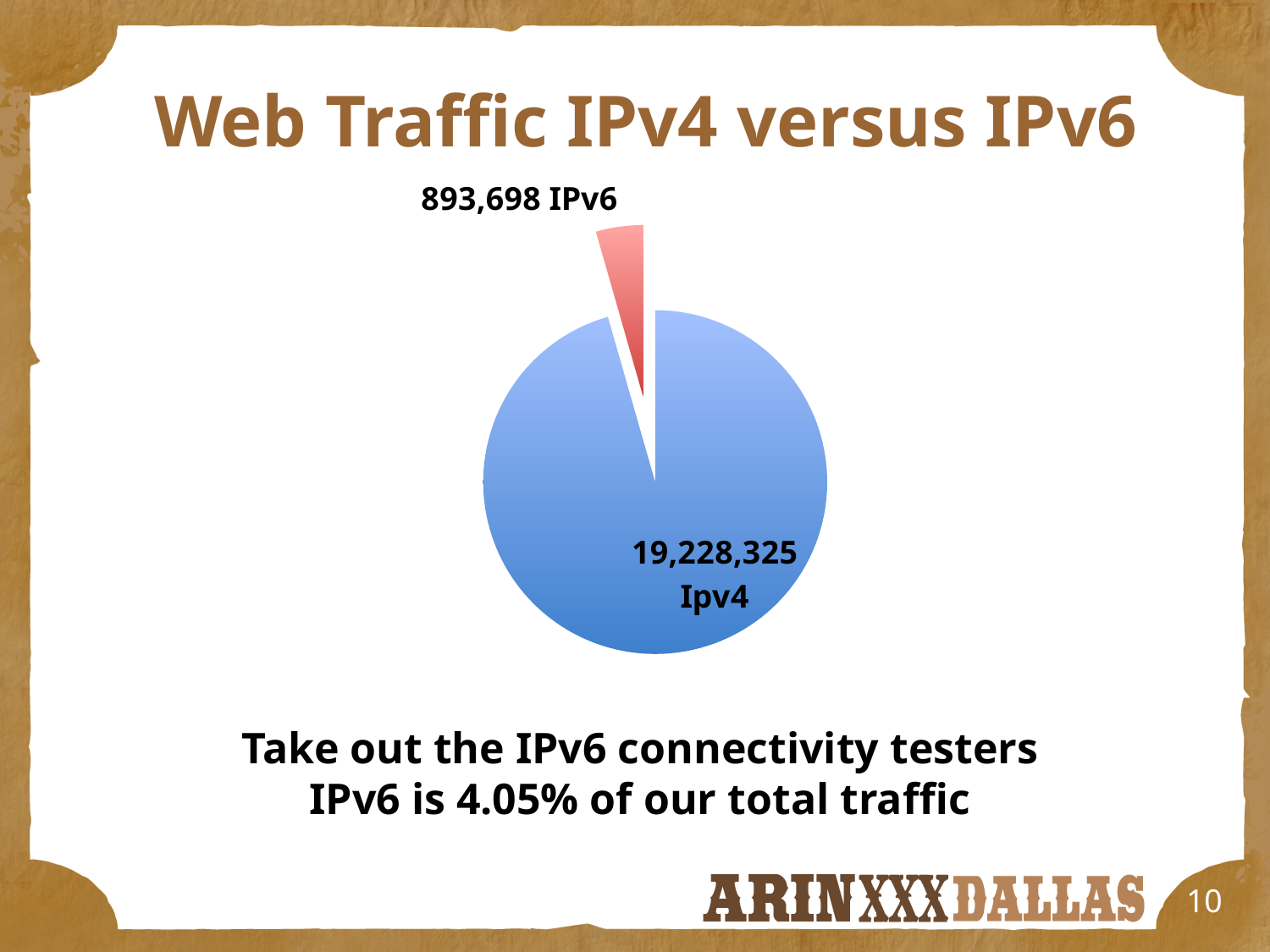
What is the difference between the IPv4 value and the IPv6 value? 18,334,627 What type of chart is shown on the slide? pie chart What is the value shown for IPv6 in the pie chart? 893,698 Which is larger, the IPv4 value or the IPv6 value? IPv4 How many slices does the pie chart have? 2 Which slice of the pie chart is the smallest? IPv6 What is the value shown for Ipv4 in the pie chart? 19,228,325 What is the title of the chart on the slide? Web Traffic IPv4 versus IPv6 What colour is the IPv6 slice in the pie chart? red What is the total of the two values shown in the pie chart? 20,122,023 Which slice of the pie chart is the largest? Ipv4